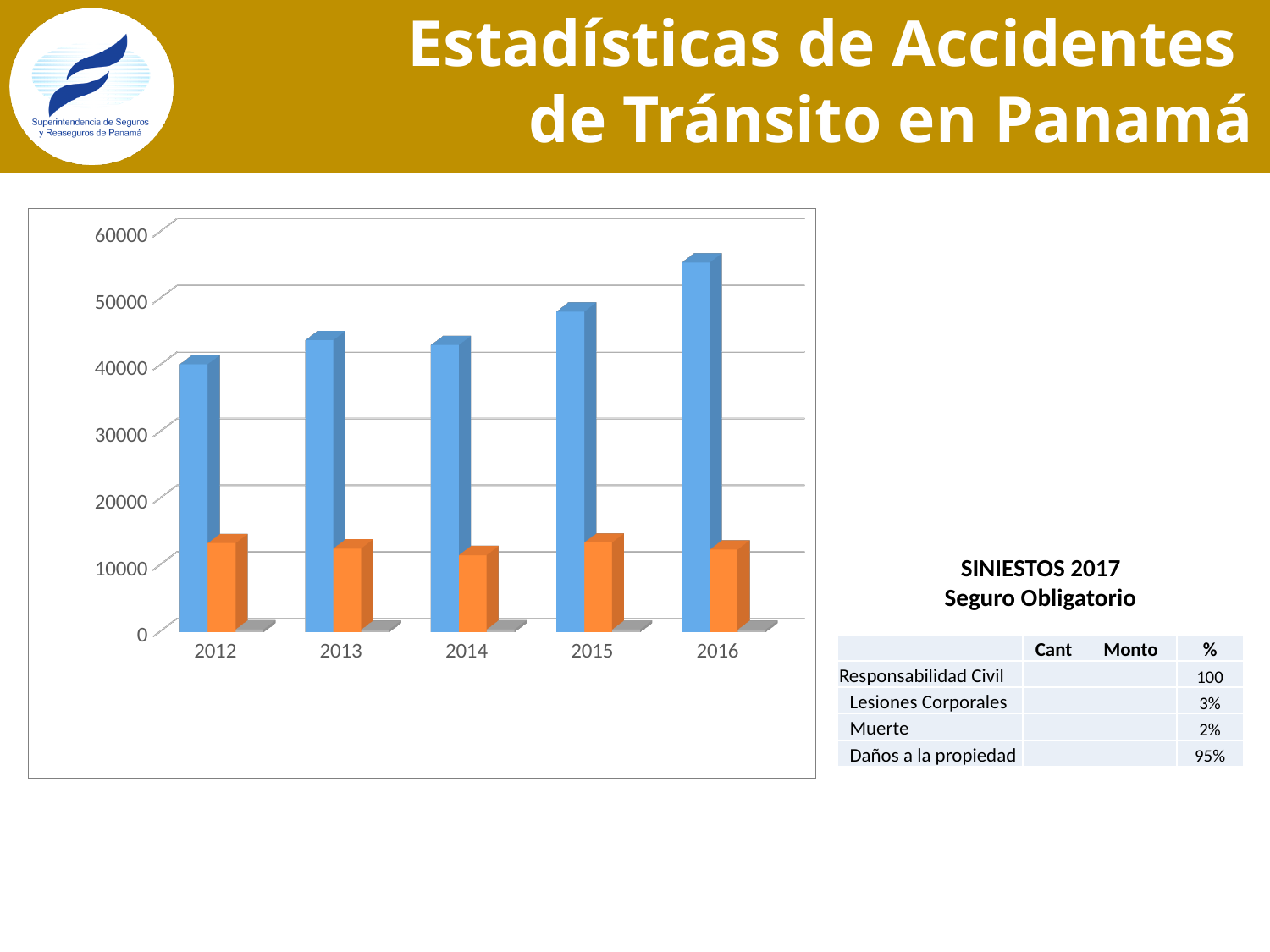
Is the orange bar for 2014 greater or less than 20000? less Which year has the tallest blue bar? 2016 Which year has the shortest blue bar? 2012 Is the blue bar for 2012 greater or less than 50000? less How many years are shown on the x axis of the chart? 5 Is the orange bar for 2012 greater or less than 10000? greater In 2013, which bar is taller, the blue one or the orange one? the blue one What is the highest value shown on the vertical axis of the chart? 60000 What kind of chart is shown on the slide? bar chart Is the blue bar for 2016 higher or lower than the blue bar for 2012? higher